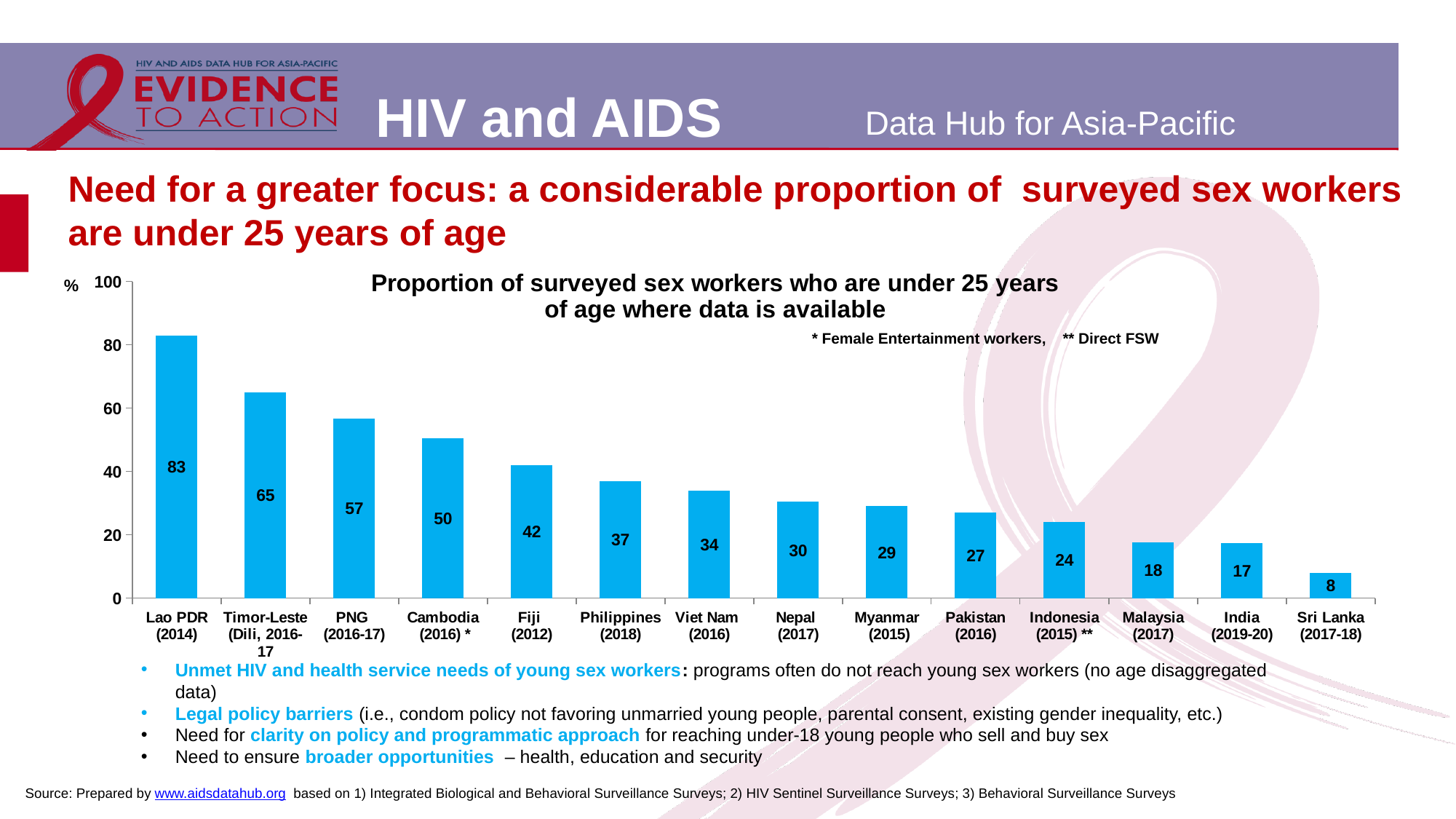
What is the title of the chart? Proportion of surveyed sex workers who are under 25 years of age where data is available How many countries are shown in the chart? 14 What is the value for Indonesia (2015)? 24 Which is larger, the value for Fiji (2012) or the value for Philippines (2018)? Fiji (2012) Is the value for Viet Nam (2016) greater or less than 40? less What is the difference between the values for Timor-Leste and PNG? 8 Which country has the highest proportion of surveyed sex workers under 25 years of age? Lao PDR (2014) Do the values rise or fall from left to right along the x axis? fall What is the value for Cambodia (2016)? 50 What is the value for Lao PDR (2014)? 83 What kind of chart is shown on the slide? bar chart Which country has the lowest proportion of surveyed sex workers under 25 years of age? Sri Lanka (2017-18)